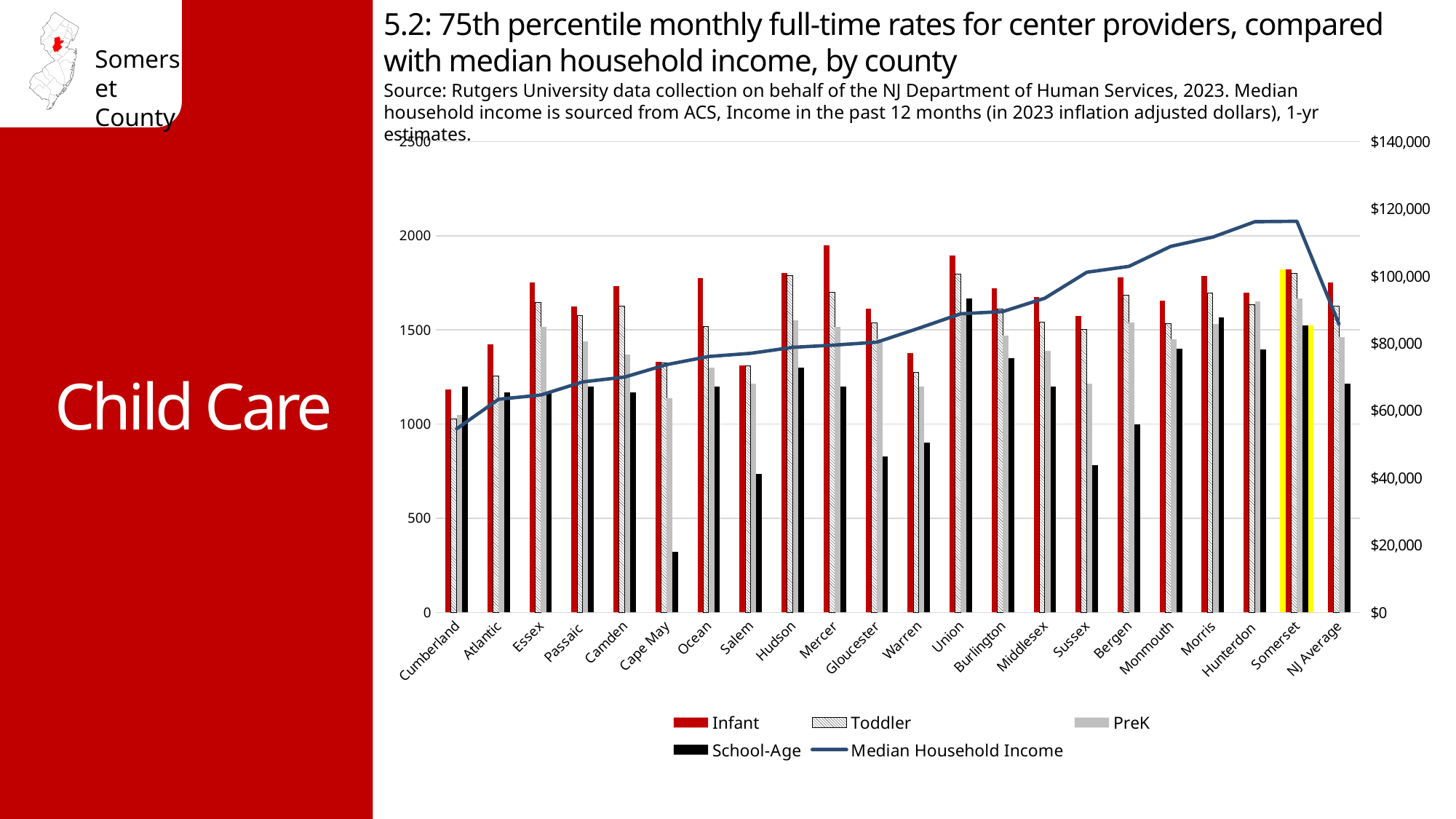
How many series does the legend list? 5 Is the School-Age rate for Cape May greater or less than 500? less Which county has the lowest Infant rate? Cumberland Is the Infant rate for Mercer greater or less than 1500? greater Is the Median Household Income for Somerset greater or less than $100,000? greater Which county has the highest School-Age rate? Union Which county has the lowest School-Age rate? Cape May Which county has the highest Infant rate? Mercer How many counties/categories are shown along the x axis? 22 Which is larger, the Infant rate for Mercer or the Infant rate for Cumberland? Mercer What kind of chart is shown on the slide? Bar chart with a line Does the Median Household Income line generally rise or fall from Cumberland to Somerset? rise